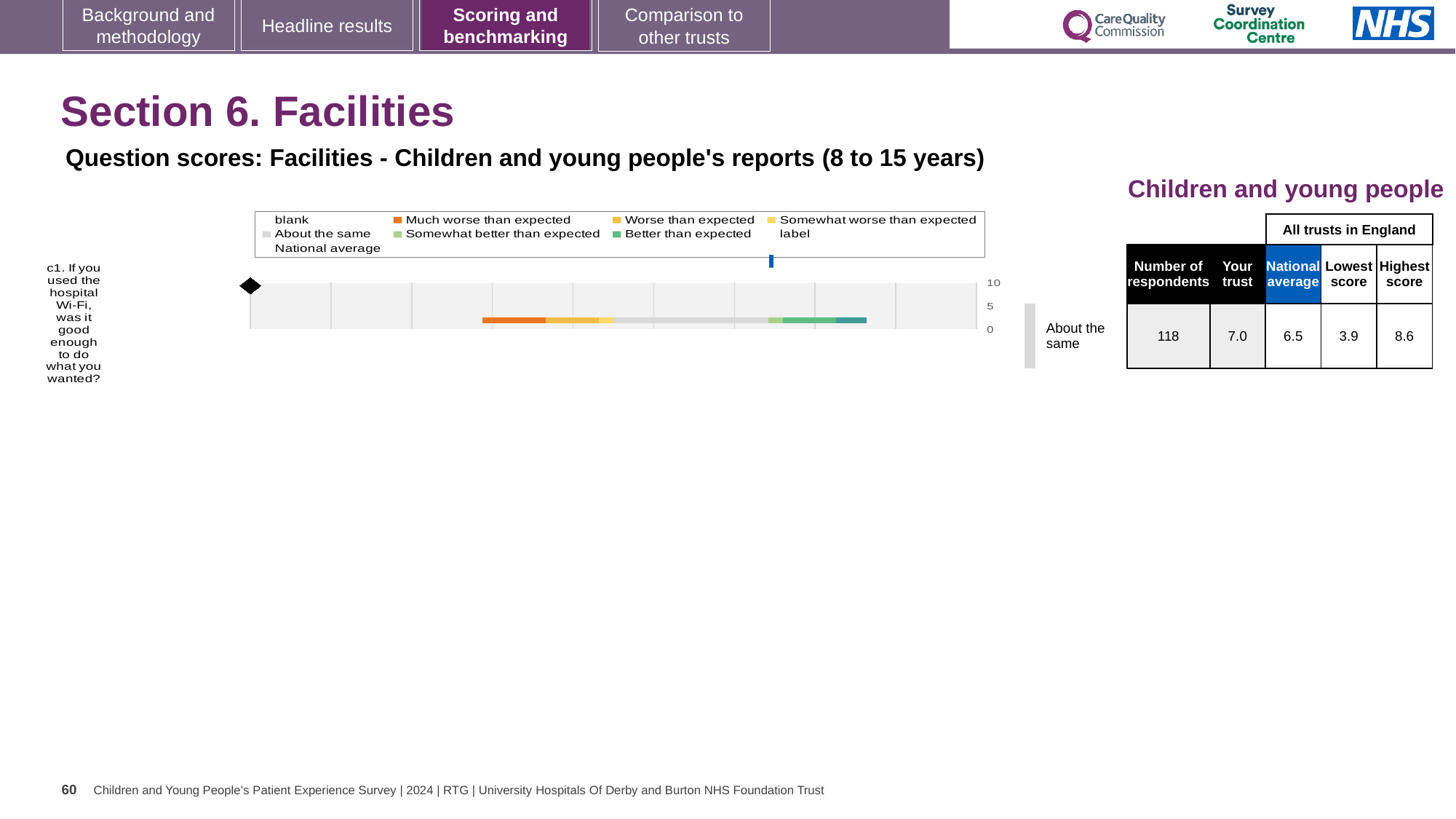
Which is larger for question c1, the 'Your trust' score or the national average? Your trust What is the lowest score among all trusts in England for question c1? 3.9 What is the difference between the highest score and the lowest score for question c1? 4.7 What is the difference between the 'Your trust' score and the national average for question c1? 0.5 What is the 'Your trust' score for question c1? 7.0 What is the highest score among all trusts in England for question c1? 8.6 Which survey question is plotted in the chart? c1. If you used the hospital Wi-Fi, was it good enough to do what you wanted? What kind of chart is shown on the slide? bar chart How many survey questions are plotted in the chart? 1 What is the national average score for question c1? 6.5 What benchmark rating is given to the trust for question c1? About the same How many respondents answered question c1? 118